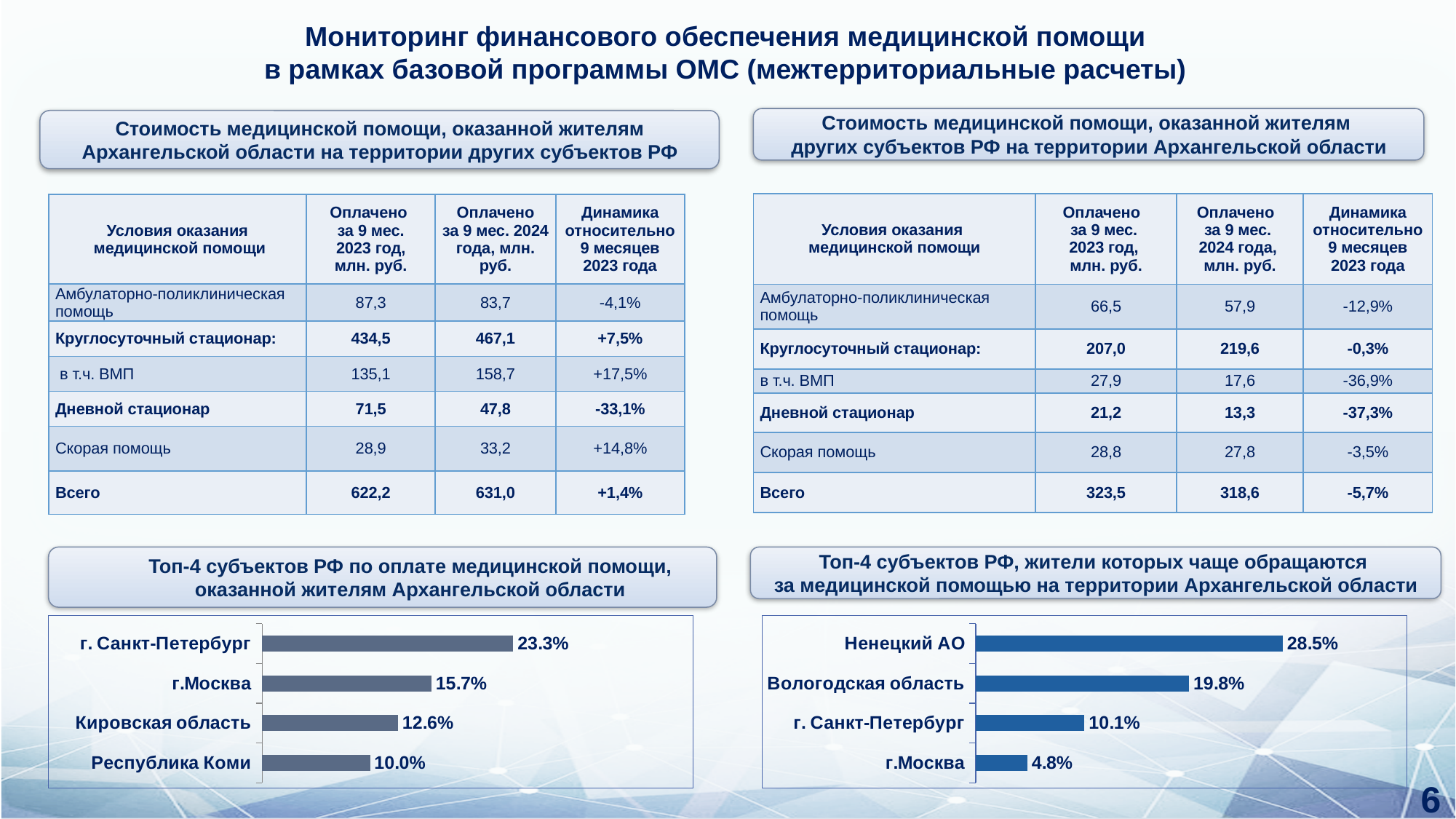
In the bottom-left chart, which category has the lowest value? Республика Коми What is the value for г. Санкт-Петербург in the bottom-right chart? 10.1% In the bottom-left chart, what is the value for Кировская область? 12.6% In the bottom-left chart (Топ-4 субъектов РФ по оплате медицинской помощи, оказанной жителям Архангельской области), what is the value for г. Санкт-Петербург? 23.3% In the bottom-right chart, what is the difference between the values for Ненецкий АО and Вологодская область? 8.7% In the bottom-right chart, what is the value for г.Москва? 4.8% In the bottom-right chart (Топ-4 субъектов РФ, жители которых чаще обращаются за медицинской помощью на территории Архангельской области), what is the value for Ненецкий АО? 28.5% In the bottom-left chart, how many categories are shown? 4 What type of chart is the bottom-left chart? Bar chart In the bottom-right chart, which is larger: the value for Вологодская область or the value for г. Санкт-Петербург? Вологодская область In the bottom-right chart, which category has the highest value? Ненецкий АО In the bottom-left chart, what is the difference between the values for г. Санкт-Петербург and г.Москва? 7.6%